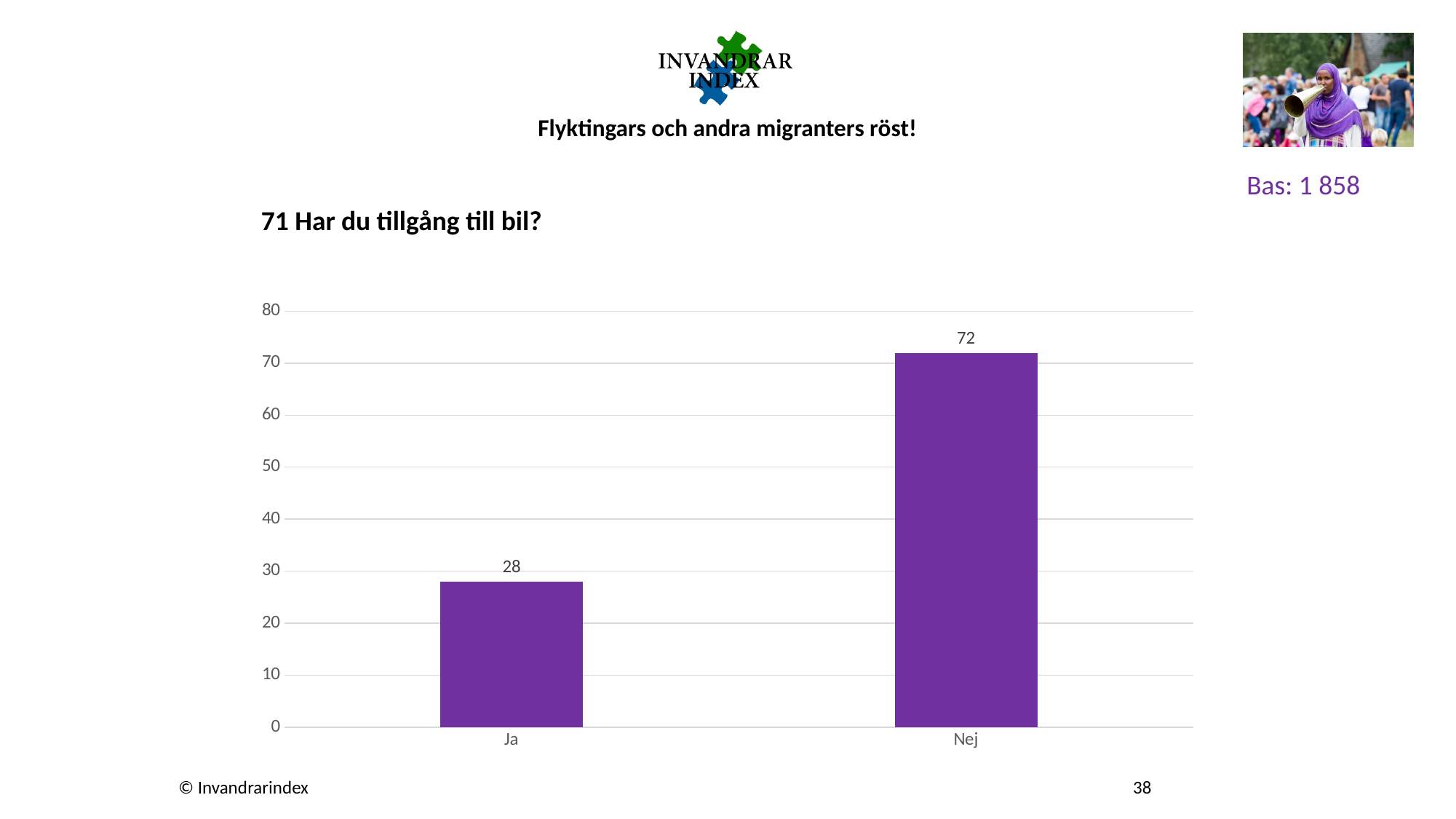
Is the value for Nej greater or less than 70? greater Which category has the highest value? Nej Which is larger, the value for Ja or the value for Nej? Nej How many categories are shown on the x axis? 2 What kind of chart is shown on the slide? bar chart What is the value for Nej? 72 Is the value for Ja greater or less than 30? less What is the value for Ja? 28 Which category has the lowest value? Ja What is the title of the chart? 71 Har du tillgång till bil? What is the difference between the values for Nej and Ja? 44 What is the highest value shown on the y axis? 80